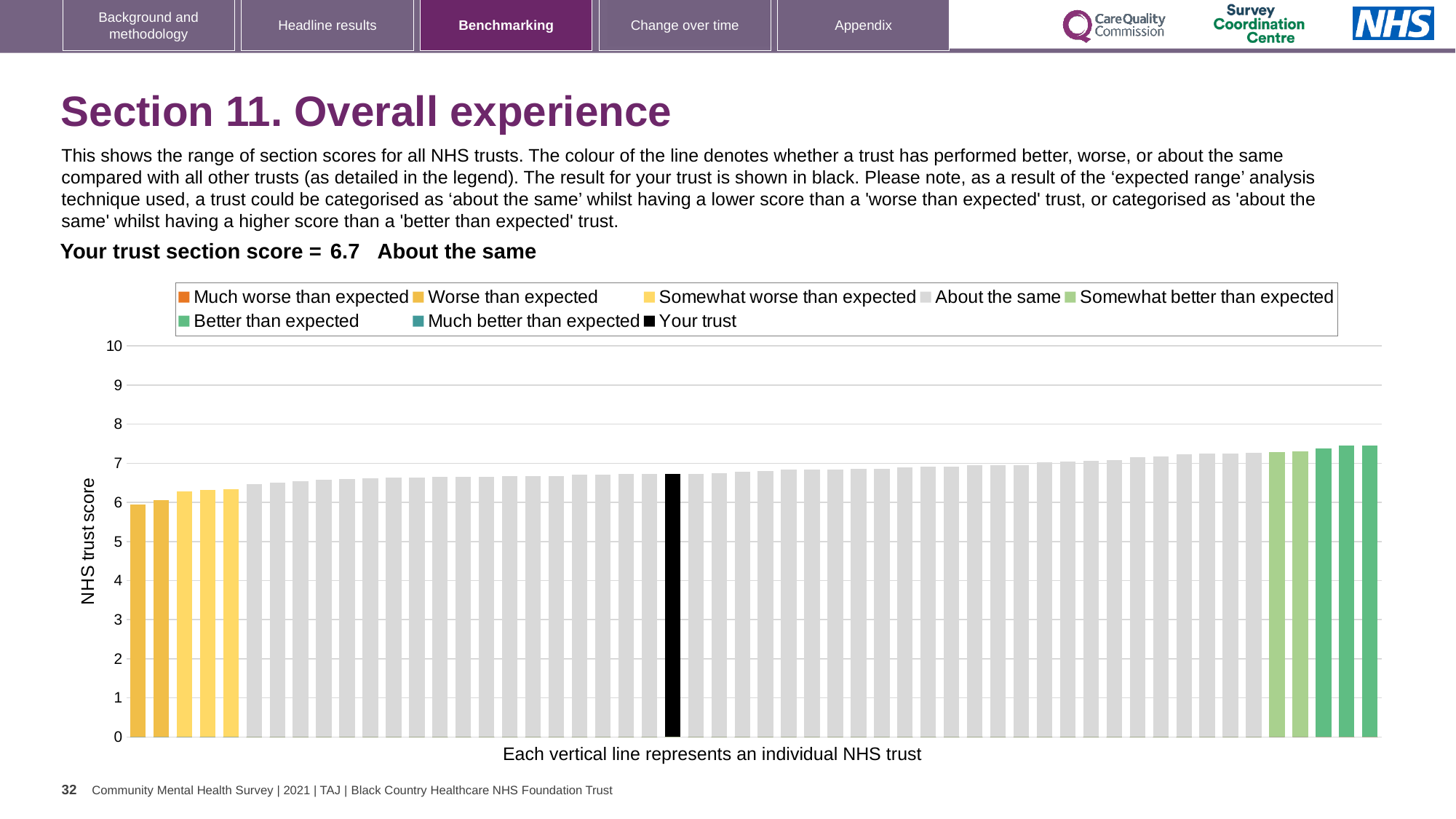
How many entries does the chart legend list? 8 What colour is the bar representing your trust? Black Do the bar values rise or fall moving from left to right along the x axis? Rise Is the value for your trust (the black bar) greater or less than 5? greater What is the label on the vertical axis of the chart? NHS trust score What kind of chart is shown on the slide? Bar chart Which benchmarking category is your trust placed in for this section? About the same Is the value of the highest bar in the chart greater or less than 8? less What is the maximum value shown on the vertical axis? 10 What is the section score for your trust? 6.7 Is the value of the lowest bar in the chart greater or less than 5? greater